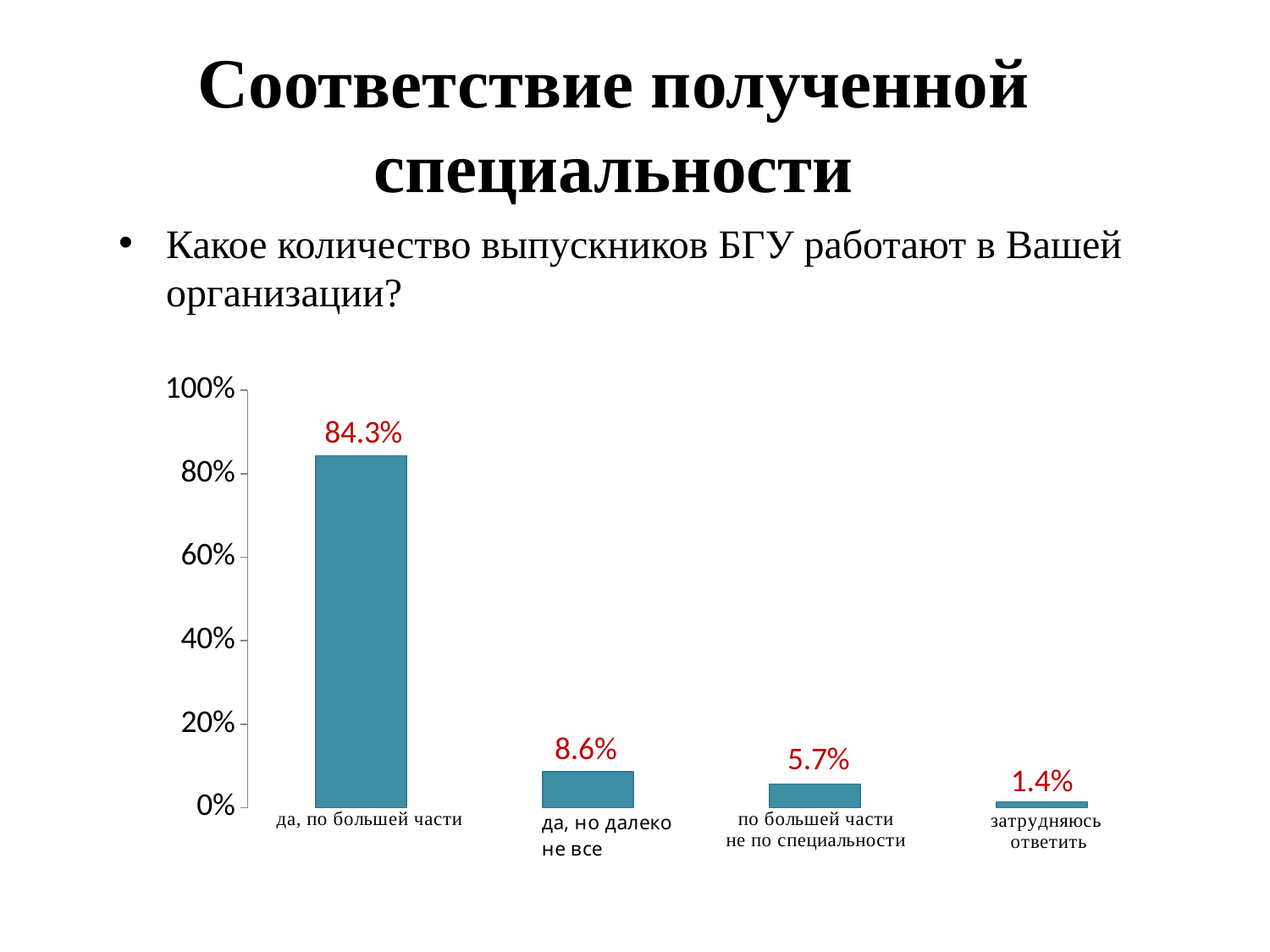
Which category has the lowest value? затрудняюсь ответить What is the difference between the values for "да, но далеко не все" and "по большей части не по специальности"? 2.9% What is the value for "затрудняюсь ответить"? 1.4% Is the value for "да, по большей части" greater or less than 80%? greater What kind of chart is shown on the slide? bar chart What is the value for "по большей части не по специальности"? 5.7% What is the value for "да, по большей части"? 84.3% What is the value for "да, но далеко не все"? 8.6% Which is larger: the value for "по большей части не по специальности" or the value for "затрудняюсь ответить"? по большей части не по специальности Which category has the highest value? да, по большей части What is the difference between the values for "да, по большей части" and "да, но далеко не все"? 75.7% How many categories are shown in the chart? 4